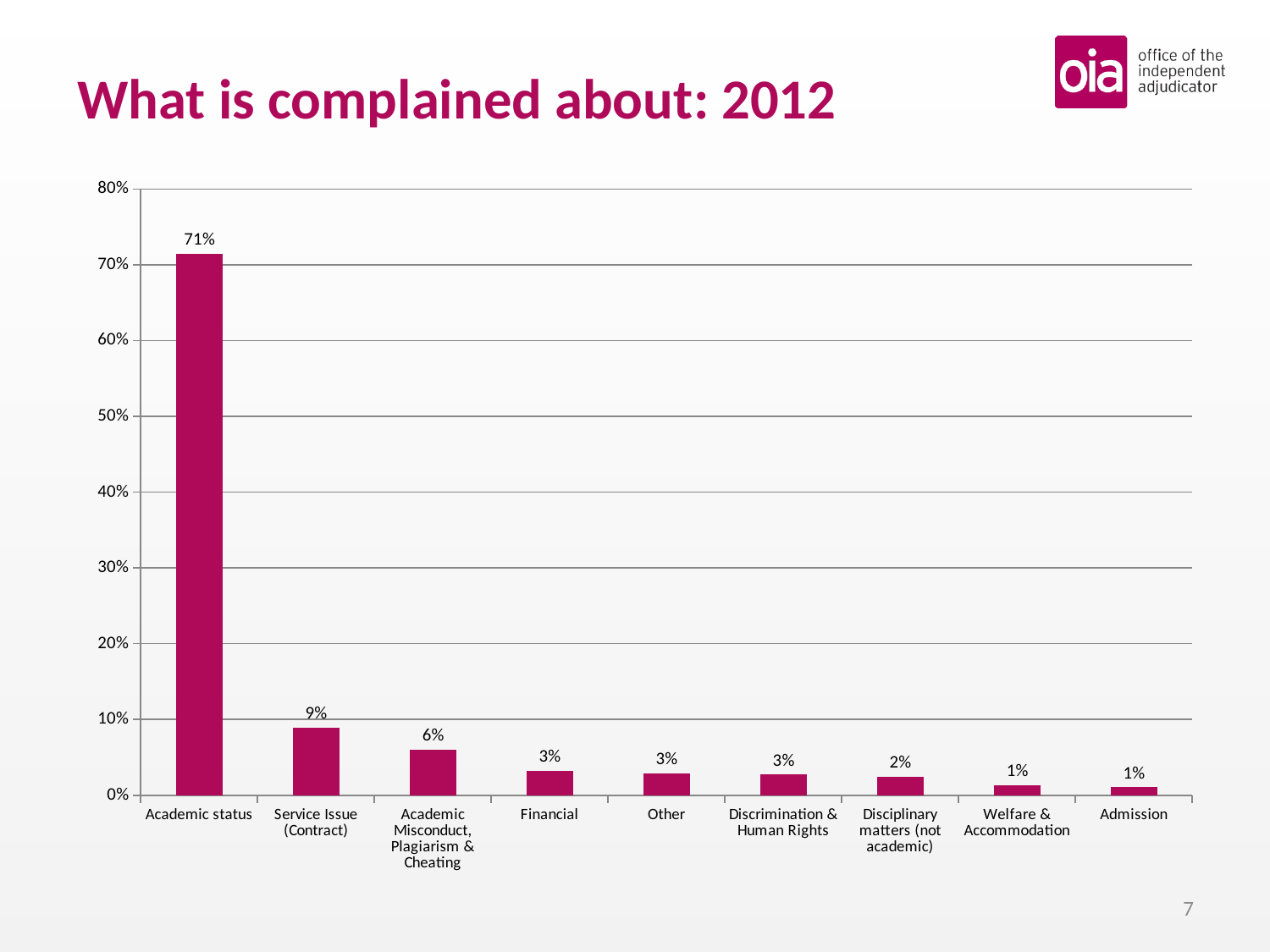
What is the value for Service Issue (Contract)? 9% What is the value for Disciplinary matters (not academic)? 2% What is the difference between the values for Service Issue (Contract) and Academic Misconduct, Plagiarism & Cheating? 3% What percentage is shown for Academic Misconduct, Plagiarism & Cheating? 6% Which category has the highest value? Academic status Is the value for Academic status greater or less than 70%? greater Which is larger, the value for Financial or the value for Welfare & Accommodation? Financial What percentage of complaints were about Academic status? 71% What is the difference between the values for Academic status and Service Issue (Contract)? 62% What kind of chart is shown on the slide? Bar chart How many categories are shown on the x axis? 9 What is the title of the slide? What is complained about: 2012